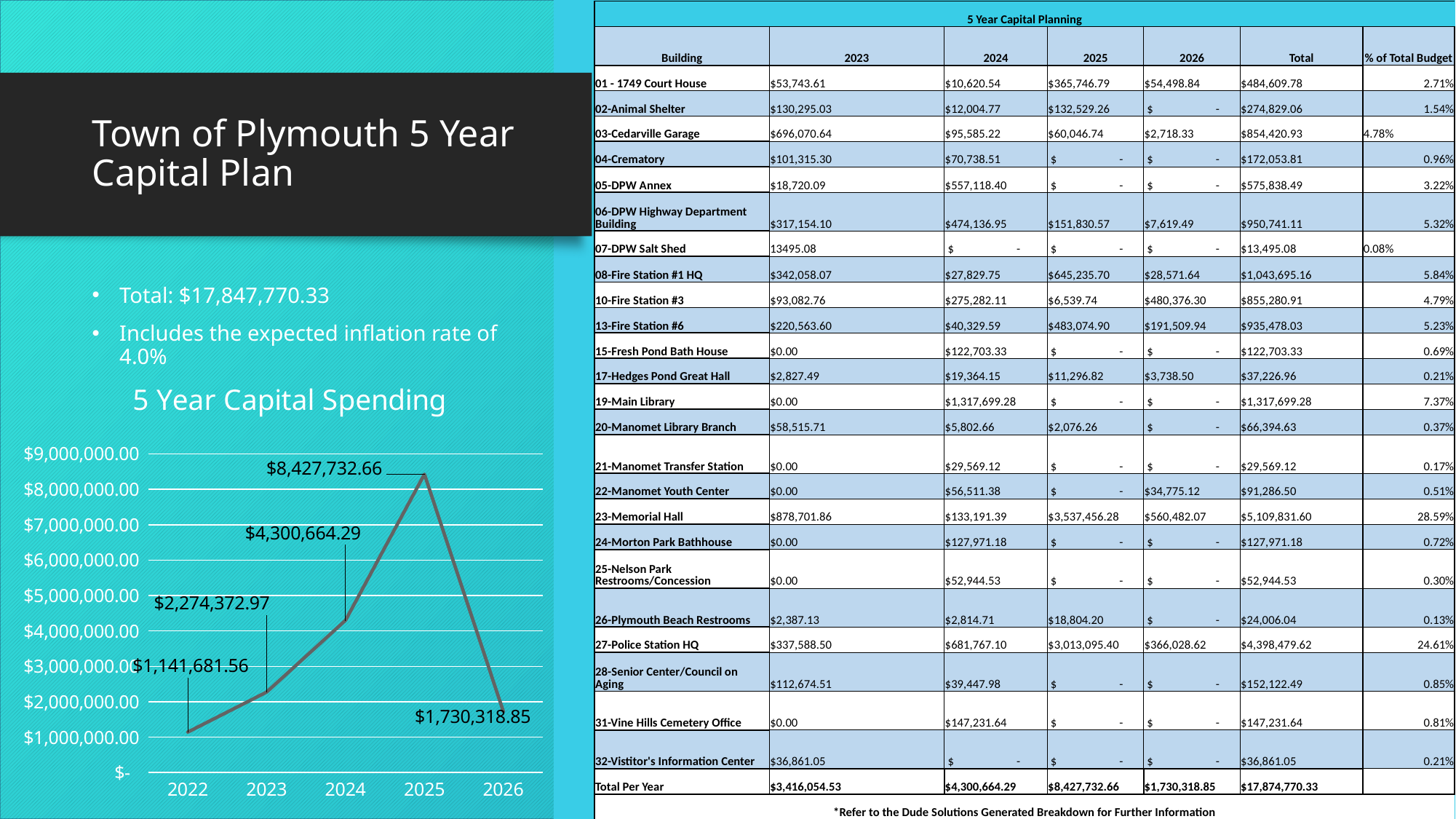
How do the values in the 5 Year Capital Spending chart change from 2022 to 2025? They rise What is the value for 2024 in the 5 Year Capital Spending chart? $4,300,664.29 How many years are plotted on the x axis of the 5 Year Capital Spending chart? 5 Which year has the highest value in the 5 Year Capital Spending chart? 2025 What is the difference between the 2025 and 2024 values in the 5 Year Capital Spending chart? $4,127,068.37 What is the value for 2026 in the 5 Year Capital Spending chart? $1,730,318.85 In the 5 Year Capital Spending chart, which is larger, the value for 2023 or the value for 2026? 2023 What is the difference between the 2025 and 2026 values in the 5 Year Capital Spending chart? $6,697,413.81 What is the value for 2025 in the 5 Year Capital Spending chart? $8,427,732.66 Which year has the lowest value in the 5 Year Capital Spending chart? 2022 What is the value for 2022 in the 5 Year Capital Spending chart? $1,141,681.56 What kind of chart is the 5 Year Capital Spending chart? Line chart